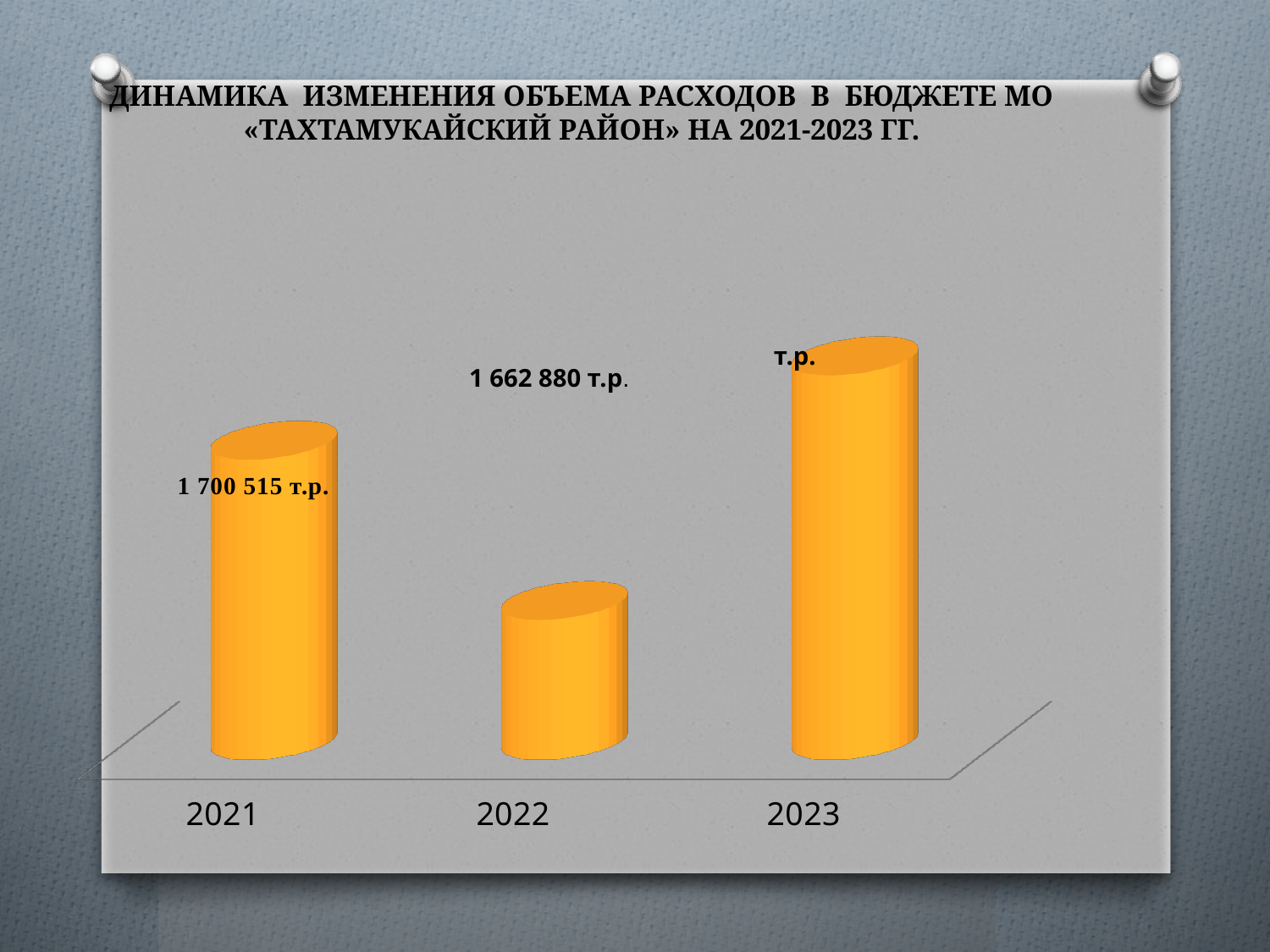
Does the value fall or rise from 2022 to 2023? Rise What colour are the bars in the chart? Orange Which year has the tallest bar? 2023 What is the value shown for 2021? 1 700 515 т.р. By how much does the value for 2021 exceed the value for 2022? 37 635 т.р. Which is larger, the value for 2021 or the value for 2022? 2021 How many years are shown on the x axis? 3 What kind of chart is shown on the slide? Bar chart What is the value shown for 2022? 1 662 880 т.р. Does the value fall or rise from 2021 to 2022? Fall Which year has the shortest bar? 2022 Which years does the chart title say the expenditure dynamics cover? 2021-2023